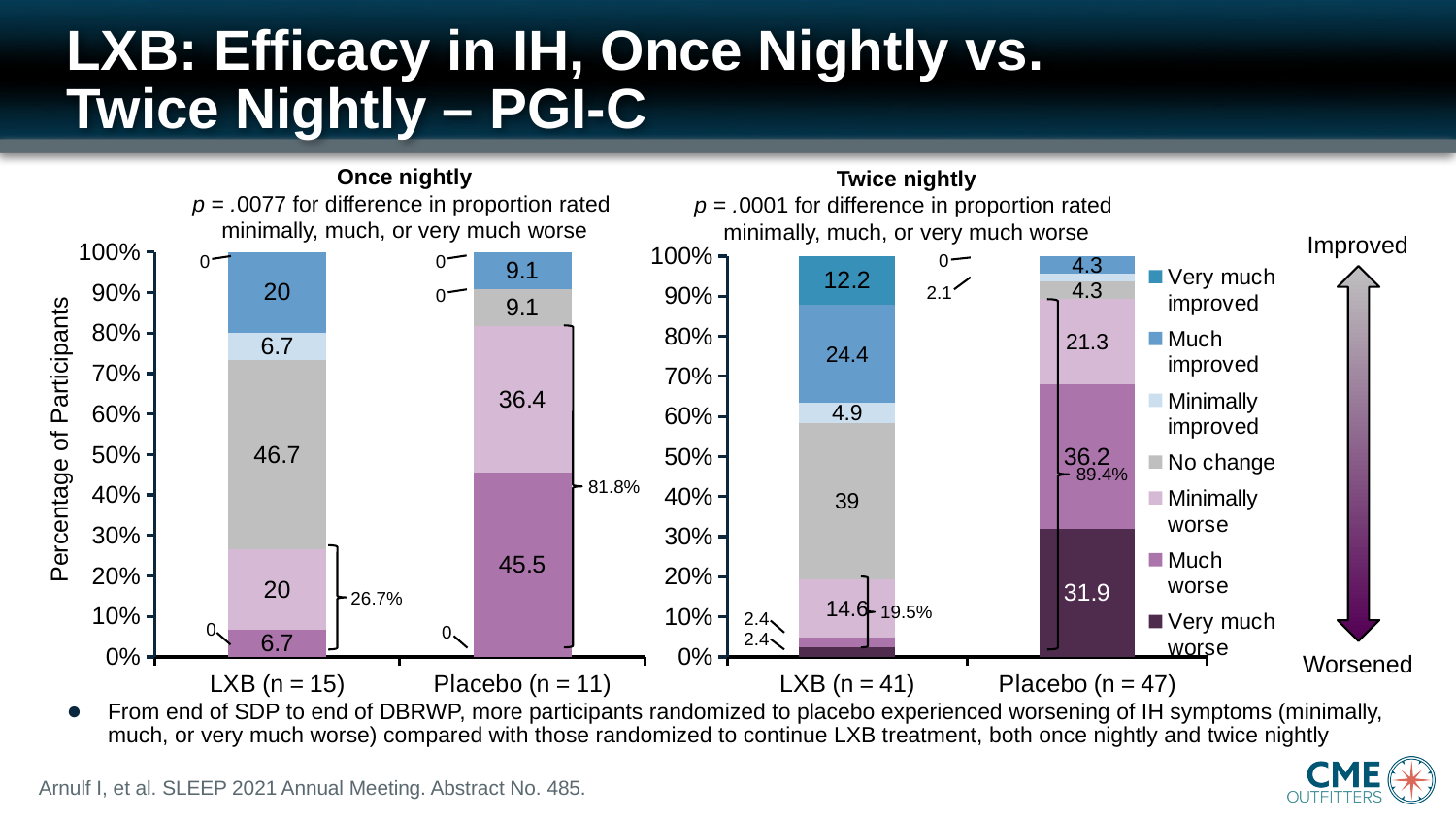
How many series does the legend list? 7 In the Twice nightly chart, which group has the larger much improved percentage, LXB (n = 41) or Placebo (n = 47)? LXB (n = 41) In the Twice nightly chart, what is the bracketed percentage of LXB (n = 41) participants rated minimally, much, or very much worse? 19.5% In the Once nightly chart, what is the bracketed percentage of Placebo (n = 11) participants rated minimally, much, or very much worse? 81.8% In the Twice nightly chart, what percentage of LXB (n = 41) participants were rated very much improved? 12.2 In the Once nightly chart, what percentage of LXB (n = 15) participants had no change? 46.7 What is the p-value shown above the Twice nightly chart for the difference in proportion rated minimally, much, or very much worse? p = .0001 In the Twice nightly chart, what percentage of Placebo (n = 47) participants were rated very much worse? 31.9 What kind of chart is used for the Once nightly data? Stacked bar chart In the Once nightly chart, what percentage of Placebo (n = 11) participants were rated much worse? 45.5 In the Twice nightly chart, is the no change value for LXB (n = 41) greater or less than 30%? greater In the Once nightly chart, what is the difference between the no change percentages for LXB (n = 15) and Placebo (n = 11)? 37.6